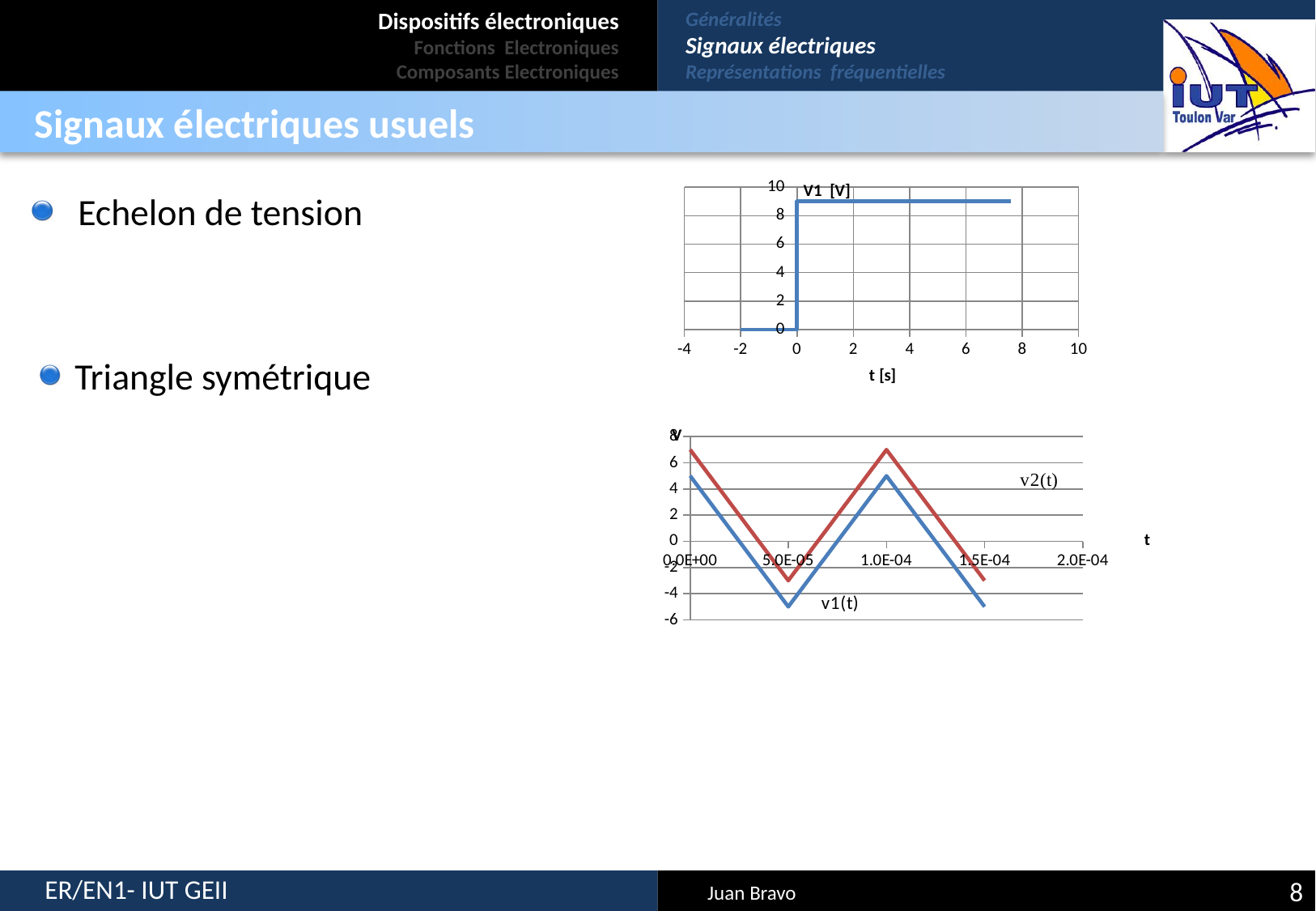
In the bottom chart (the triangle chart), is the value of v2(t) at t = 5.0E-05 greater or less than -2? less In the top chart "V1 [V]", between t = 2 and t = 6, does V1 rise, fall or stay constant? stay constant What kind of chart is the top chart titled "V1 [V]"? line chart In the top chart "V1 [V]", what is the label of the horizontal axis? t [s] In the bottom chart (the triangle chart), is the value of v2(t) at t = 1.0E-04 greater or less than 6? greater In the bottom chart (the triangle chart), is the value of v1(t) at t = 5.0E-05 greater or less than -4? less In the bottom chart (the triangle chart), what colour is the v1(t) line? blue In the bottom chart (the triangle chart), between t = 5.0E-05 and t = 1.0E-04, does v1(t) rise or fall? rise In the bottom chart (the triangle chart), at t = 1.0E-04, which series has the larger value, v1(t) or v2(t)? v2(t) How many series are plotted in the bottom chart (the triangle chart)? 2